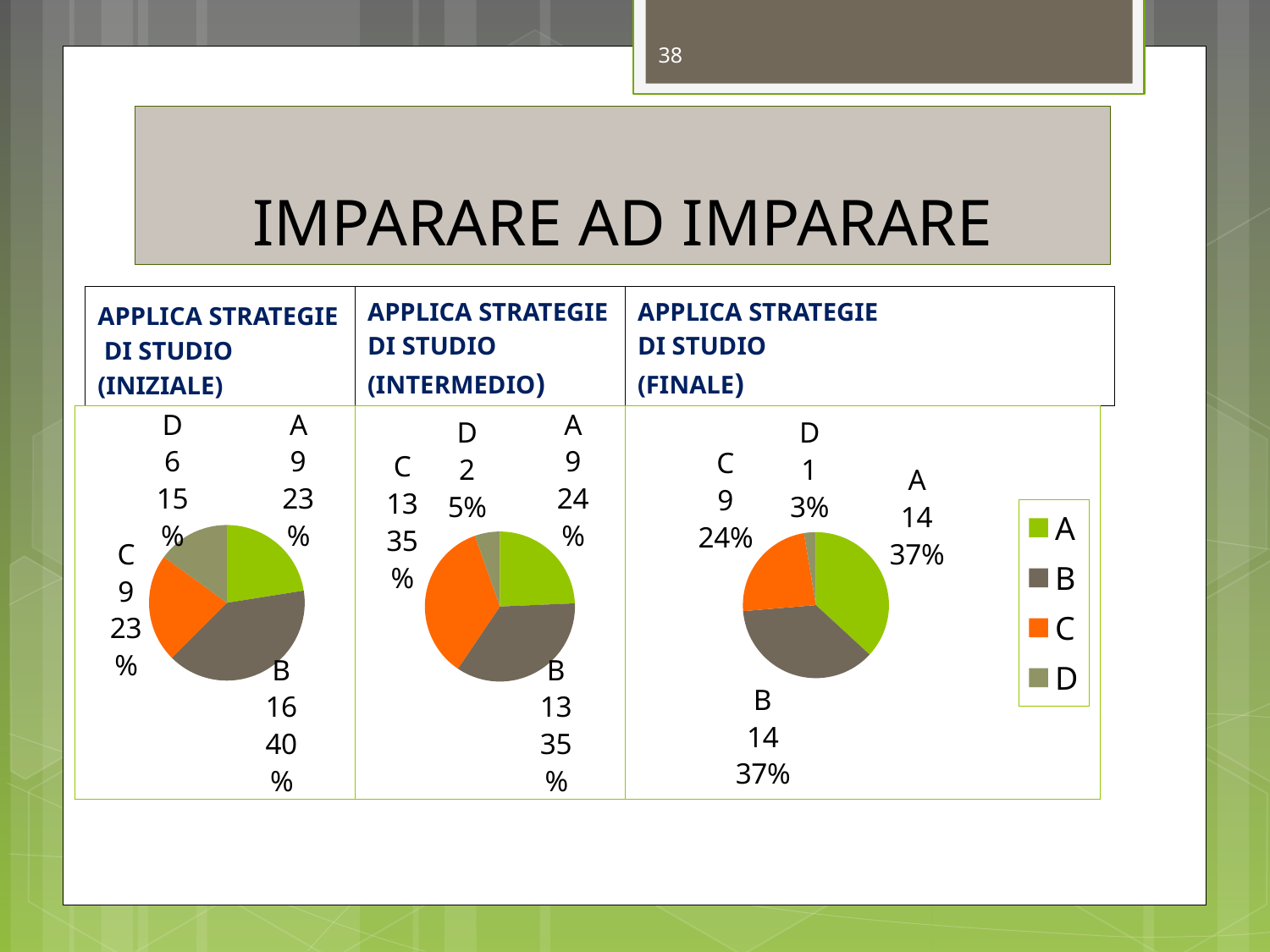
In the APPLICA STRATEGIE DI STUDIO (INIZIALE) chart, what percentage does slice B represent? 40% How many categories does the legend on the slide list? 4 In the APPLICA STRATEGIE DI STUDIO (FINALE) chart, what is the difference between the counts for A and D? 13 In the APPLICA STRATEGIE DI STUDIO (FINALE) chart, what is the count for category A? 14 In the APPLICA STRATEGIE DI STUDIO (INTERMEDIO) chart, what percentage does slice A represent? 24% What kind of chart is used for APPLICA STRATEGIE DI STUDIO (FINALE)? Pie chart In the APPLICA STRATEGIE DI STUDIO (FINALE) chart, what percentage does slice C represent? 24% In the APPLICA STRATEGIE DI STUDIO (INTERMEDIO) chart, what is the count for category D? 2 In the APPLICA STRATEGIE DI STUDIO (INIZIALE) chart, which is larger, the count for B or the count for C? B In the APPLICA STRATEGIE DI STUDIO (INIZIALE) chart, which category has the largest slice? B In the APPLICA STRATEGIE DI STUDIO (INTERMEDIO) chart, which category has the smallest slice? D In the APPLICA STRATEGIE DI STUDIO (INIZIALE) chart, what is the count for category D? 6